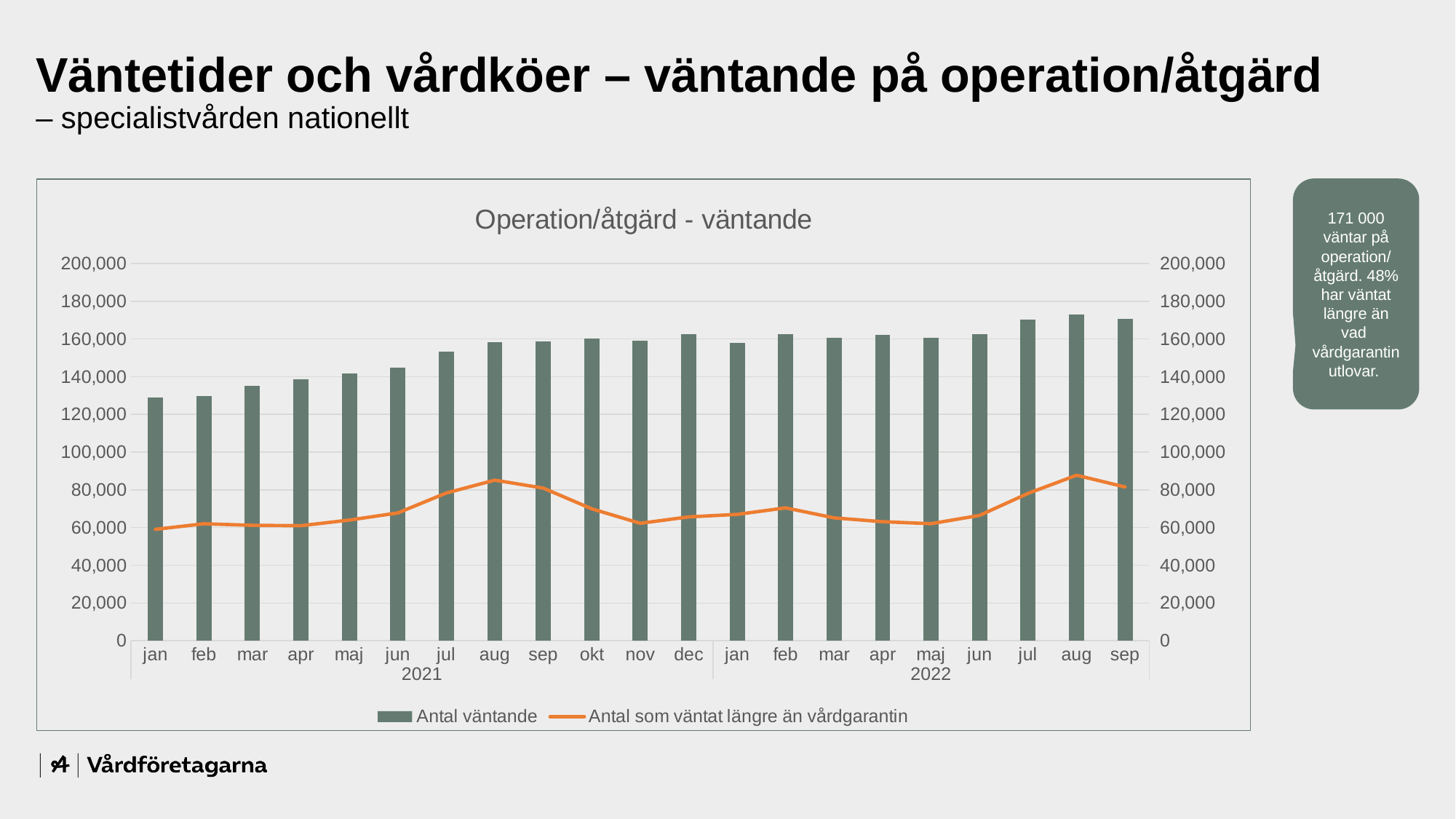
Is the value of Antal som väntat längre än vårdgarantin for nov 2021 greater or less than 80,000? less What kind of chart is shown on the slide? A combined bar and line chart How many months are plotted along the x axis? 21 Which month has the lowest bar for Antal väntande? jan 2021 How many series does the legend list? 2 Do the Antal väntande bars generally rise or fall from jan 2021 to sep 2022? rise Is the Antal väntande bar for jan 2021 greater or less than 140,000? less Is the Antal väntande bar for aug 2022 greater or less than 160,000? greater Which is larger, the Antal väntande bar for jan 2021 or for dec 2021? dec 2021 Which series is drawn as an orange line? Antal som väntat längre än vårdgarantin What is the title of the chart? Operation/åtgärd - väntande